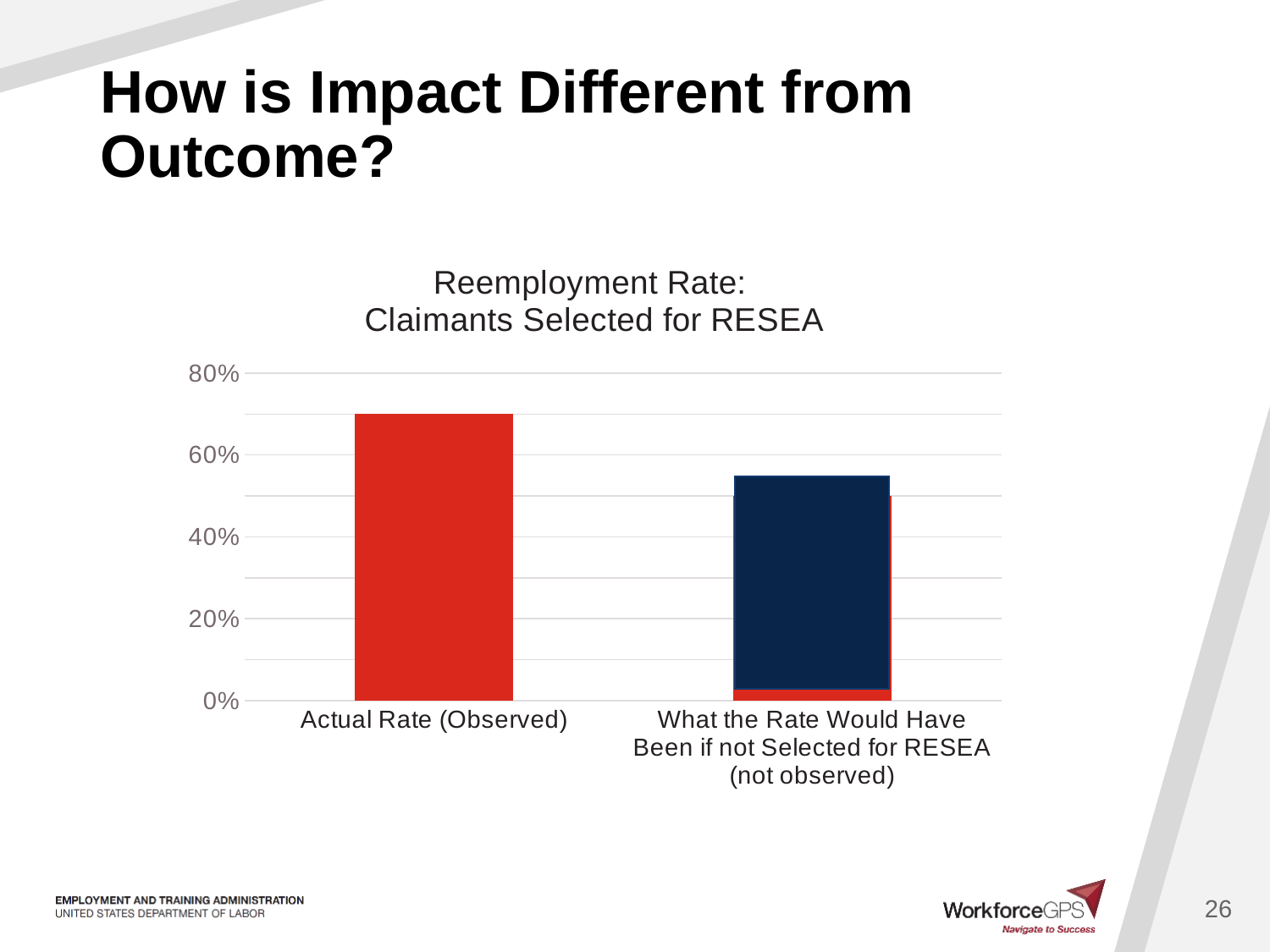
Which is larger: the Actual Rate (Observed) or What the Rate Would Have Been if not Selected for RESEA (not observed)? Actual Rate (Observed) What is the highest value labelled on the vertical axis of the chart? 80% What is the title of the chart? Reemployment Rate: Claimants Selected for RESEA Is the value for Actual Rate (Observed) greater or less than 80%? less What kind of chart is shown on the slide? bar chart Which category has the lowest reemployment rate? What the Rate Would Have Been if not Selected for RESEA (not observed) Is the value for What the Rate Would Have Been if not Selected for RESEA (not observed) greater or less than 60%? less Is the value for Actual Rate (Observed) greater or less than 60%? greater How many categories are plotted on the x axis of the chart? 2 Which category has the highest reemployment rate? Actual Rate (Observed)